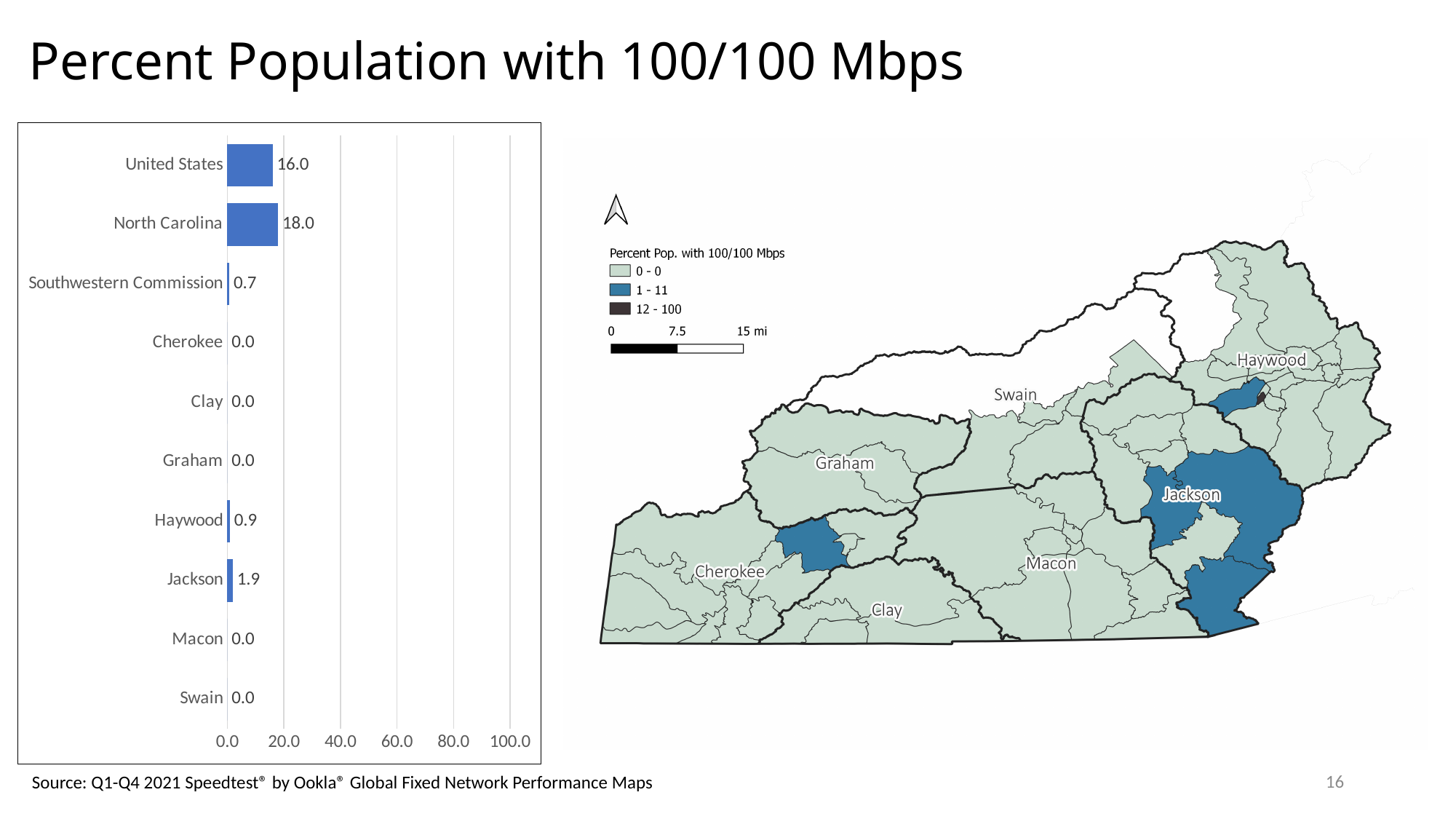
How many counties in the bar chart have a value of 0.0? 5 What is the difference between the values for North Carolina and the United States in the bar chart? 2.0 Which category has the highest value in the bar chart? North Carolina What is the value for Southwestern Commission in the bar chart? 0.7 What is the value for the United States in the bar chart? 16.0 Which is larger in the bar chart, the value for Jackson or the value for Haywood? Jackson What is the value for Jackson in the bar chart? 1.9 What is the value for North Carolina in the bar chart? 18.0 Is the value for the United States in the bar chart greater or less than 20.0? less What is the value for Haywood in the bar chart? 0.9 How many categories are shown in the bar chart? 10 What kind of chart is shown on the left of the slide? bar chart